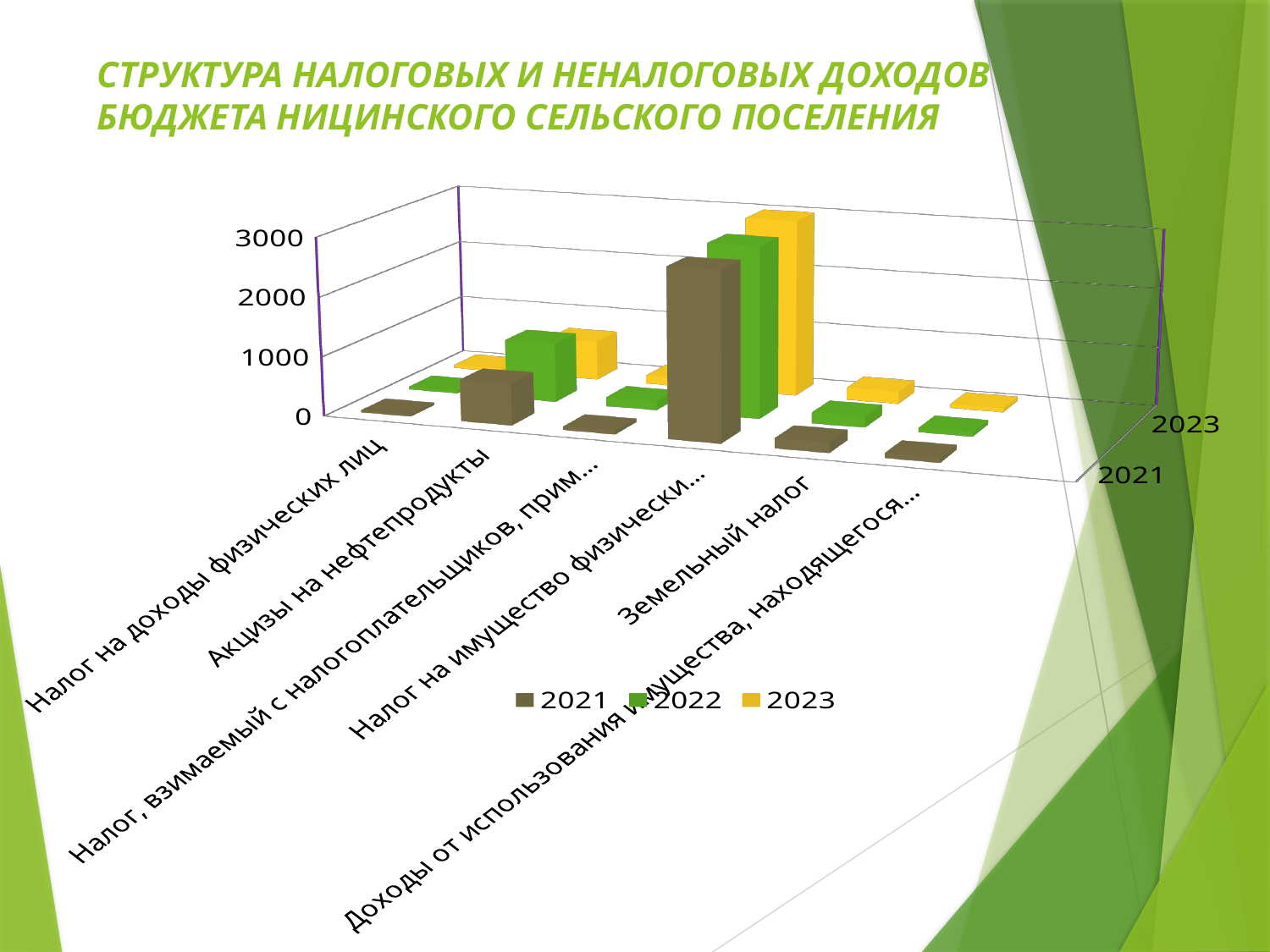
Is the 2021 value for Налог на доходы физических лиц greater or less than 1000? less Which is larger in 2021: Налог на имущество физических лиц or Акцизы на нефтепродукты? Налог на имущество физических лиц Is the 2023 value for Налог на имущество физических лиц greater or less than 1000? greater Which category has the highest bars in the chart? Налог на имущество физических лиц Which colour represents the 2023 series in the chart? yellow Is the 2023 value for Земельный налог greater or less than 1000? less Which is larger in 2022: Акцизы на нефтепродукты or Налог на доходы физических лиц? Акцизы на нефтепродукты Which years are listed in the chart legend? 2021, 2022, 2023 How many series does the legend list? 3 What kind of chart is shown on the slide? bar chart How many revenue categories are shown along the x axis? 6 Do the values for Налог на имущество физических лиц rise or fall from 2021 to 2023? rise